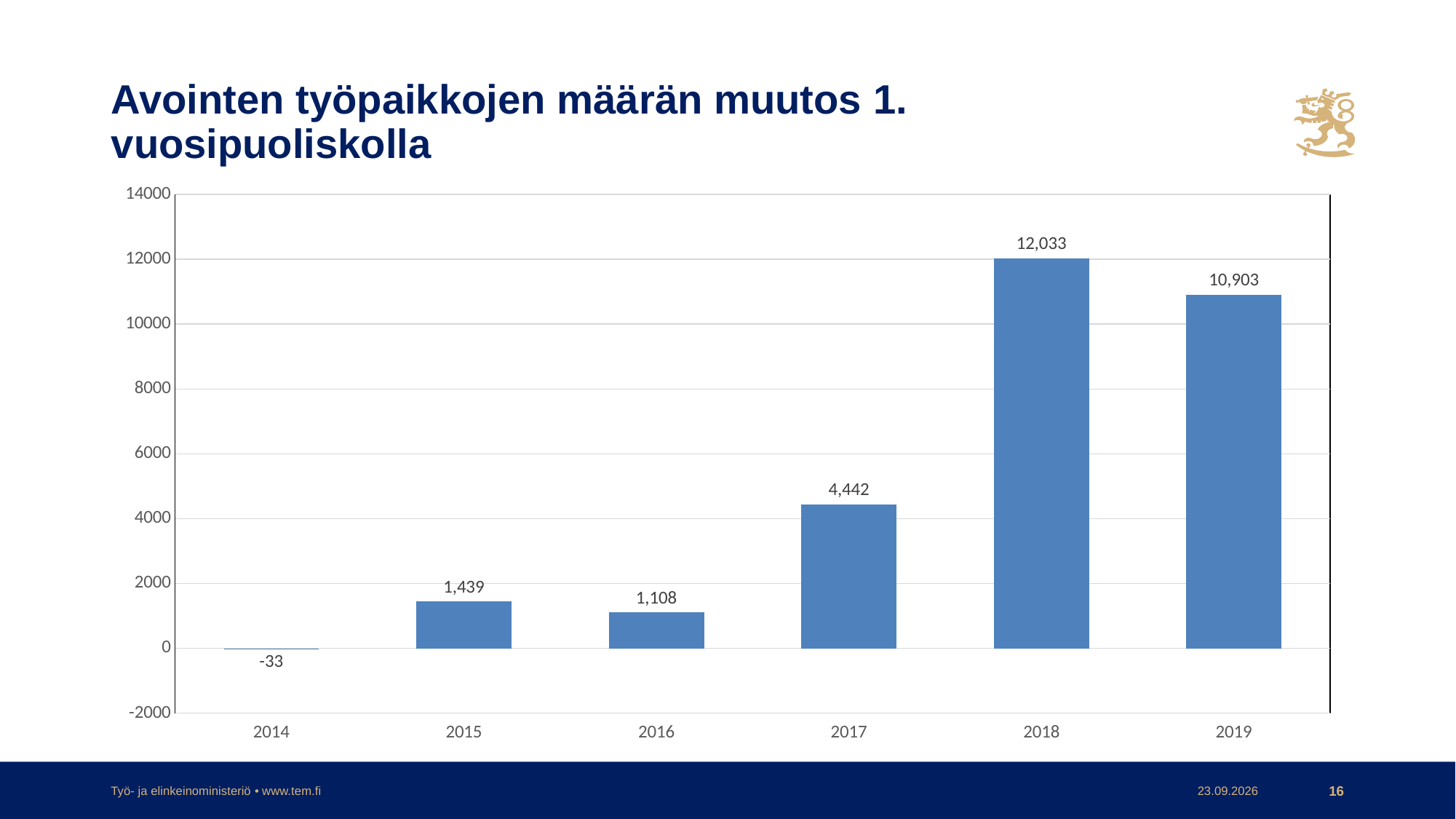
What is the difference between the values for 2018 and 2019? 1,130 Which is larger, the value for 2015 or the value for 2016? 2015 Which year has the highest value? 2018 What is the difference between the values for 2015 and 2016? 331 What kind of chart is shown on the slide? bar chart What is the title of the slide? Avointen työpaikkojen määrän muutos 1. vuosipuoliskolla What is the value for 2014? -33 How many years are shown on the x axis? 6 What is the value for 2018? 12,033 Which year has the lowest value? 2014 What is the value for 2017? 4,442 Is the value for 2019 greater or less than 10000? greater